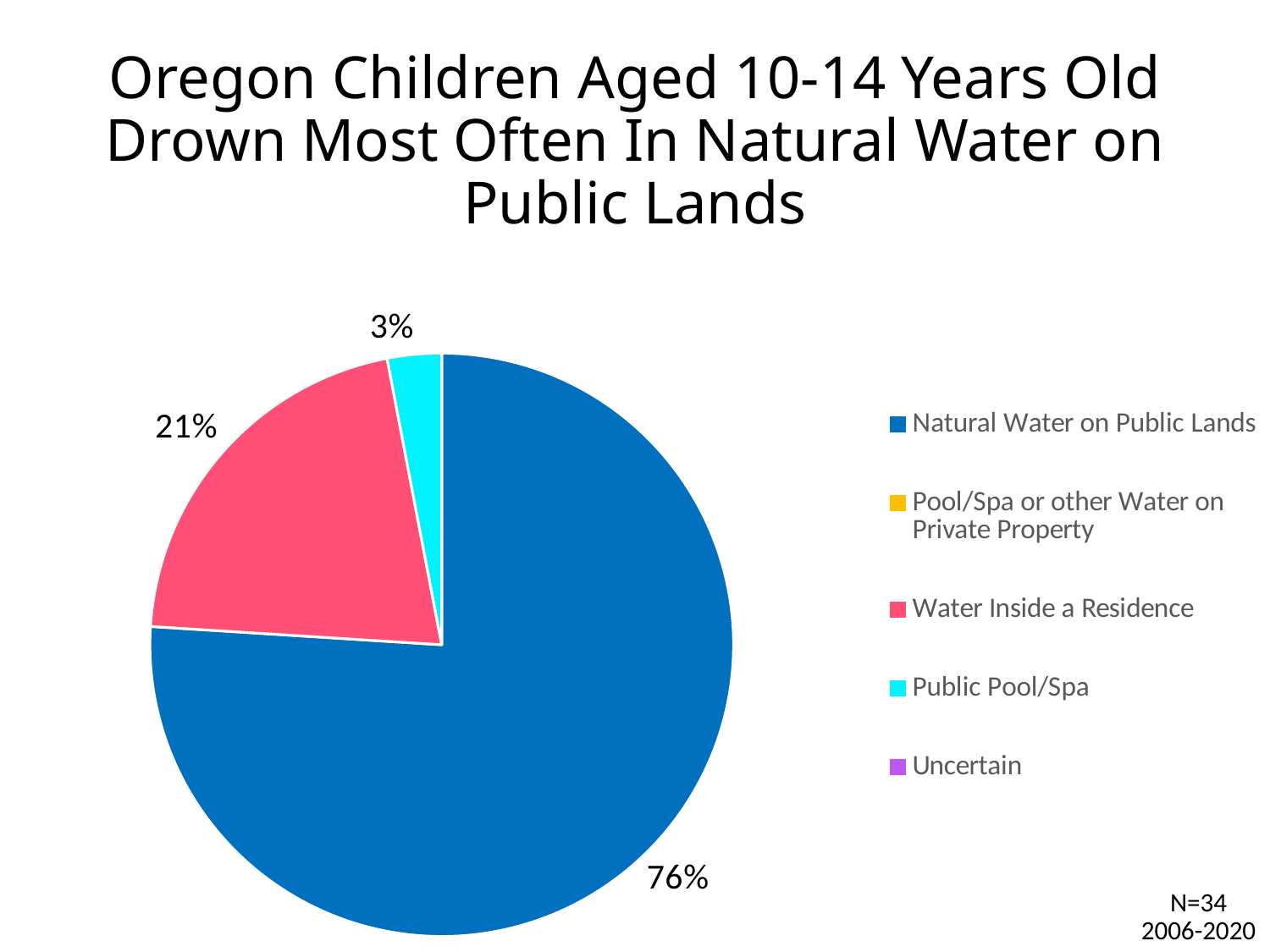
What percentage is shown for Public Pool/Spa? 3% How many categories does the legend list? 5 Which is larger, the slice for Water Inside a Residence or the slice for Public Pool/Spa? Water Inside a Residence What is the sample size (N) noted on the slide? N=34 What kind of chart is shown on the slide? Pie chart What is the difference in percentage points between Natural Water on Public Lands and Water Inside a Residence? 55 Which labeled slice of the pie is the smallest? Public Pool/Spa What years does the data on the slide cover? 2006-2020 What share of the pie is Natural Water on Public Lands? 76% Which category has the largest slice of the pie? Natural Water on Public Lands What percentage is shown for Water Inside a Residence? 21%